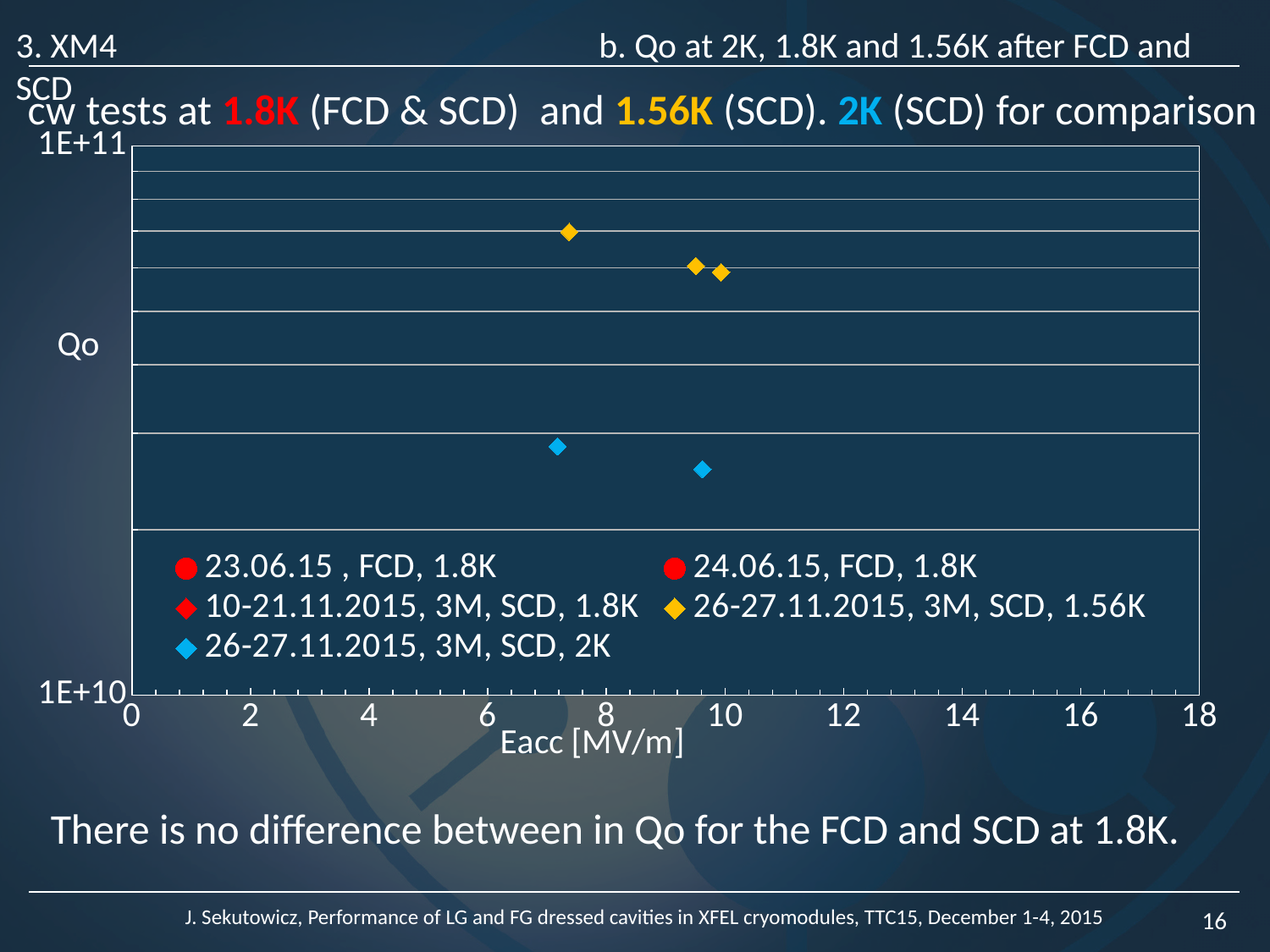
How many data points are plotted for the 26-27.11.2015, 3M, SCD, 2K series? 2 Do the Qo values of the 26-27.11.2015, 3M, SCD, 2K series rise or fall as Eacc increases? fall What kind of chart is shown on the slide? scatter chart Which series has higher Qo values, the 26-27.11.2015, 3M, SCD, 1.56K series or the 26-27.11.2015, 3M, SCD, 2K series? 26-27.11.2015, 3M, SCD, 1.56K What is the maximum value shown on the x axis? 18 How many data points are plotted for the 26-27.11.2015, 3M, SCD, 1.56K series? 3 Which series has the highest plotted Qo values on the chart? 26-27.11.2015, 3M, SCD, 1.56K How many series does the chart legend list? 5 Which series has the lowest plotted Qo values on the chart? 26-27.11.2015, 3M, SCD, 2K What is the label of the x axis? Eacc [MV/m] Do the Qo values of the 26-27.11.2015, 3M, SCD, 1.56K series rise or fall as Eacc increases? fall What is the label of the y axis? Qo